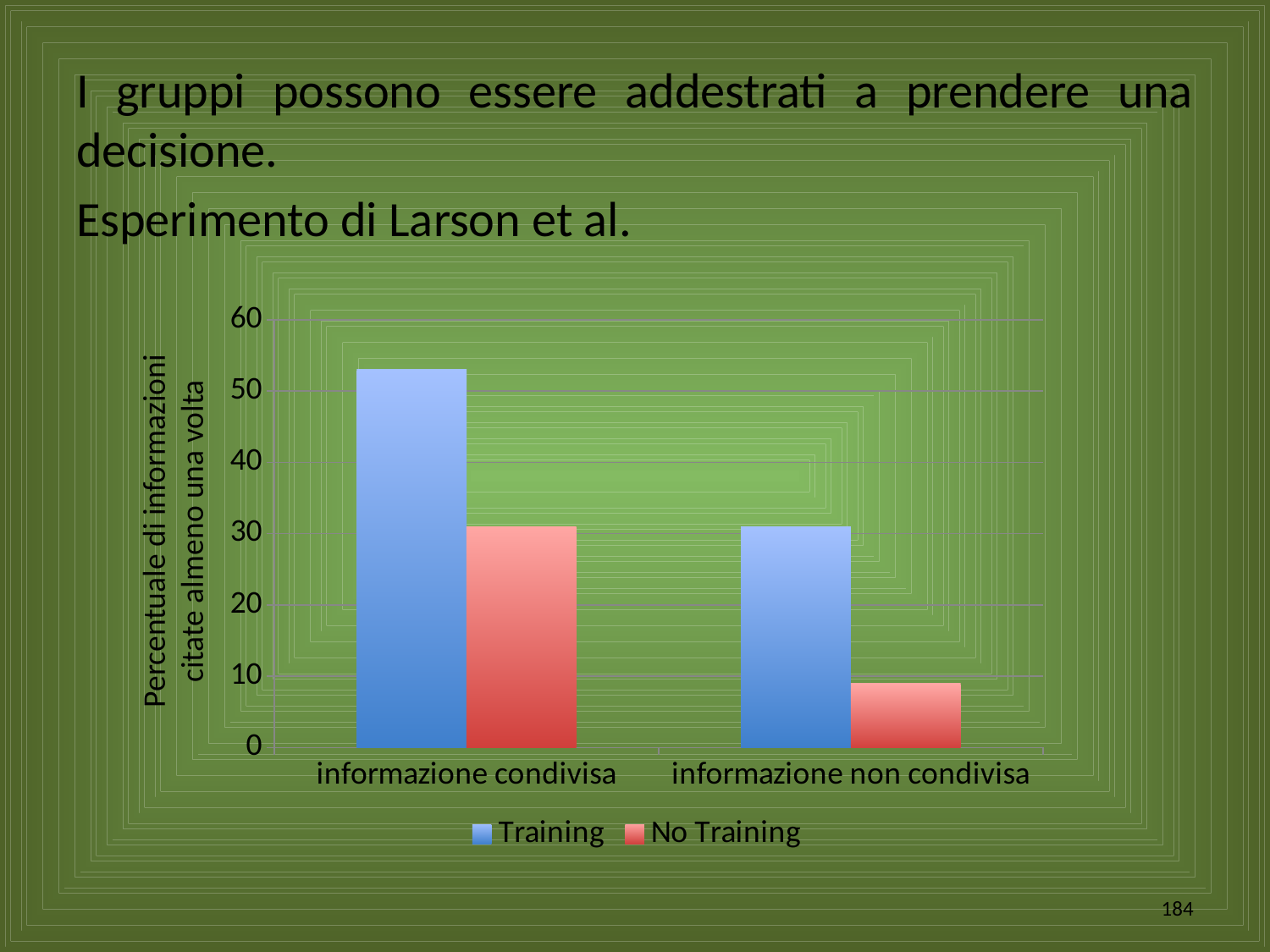
Is the Training value for informazione condivisa greater or less than 40? greater Is the No Training value for informazione non condivisa greater or less than 20? less What kind of chart is shown on the slide? bar chart For informazione condivisa, which is larger: Training or No Training? Training Which bar is the lowest in the chart? No Training, informazione non condivisa What are the two series named in the legend? Training, No Training Which bar is the highest in the chart? Training, informazione condivisa How many categories are shown on the x axis? 2 What is the y-axis label of the chart? Percentuale di informazioni citate almeno una volta For the Training series, which category has the larger value: informazione condivisa or informazione non condivisa? informazione condivisa For informazione non condivisa, which is larger: Training or No Training? Training How many series does the legend list? 2